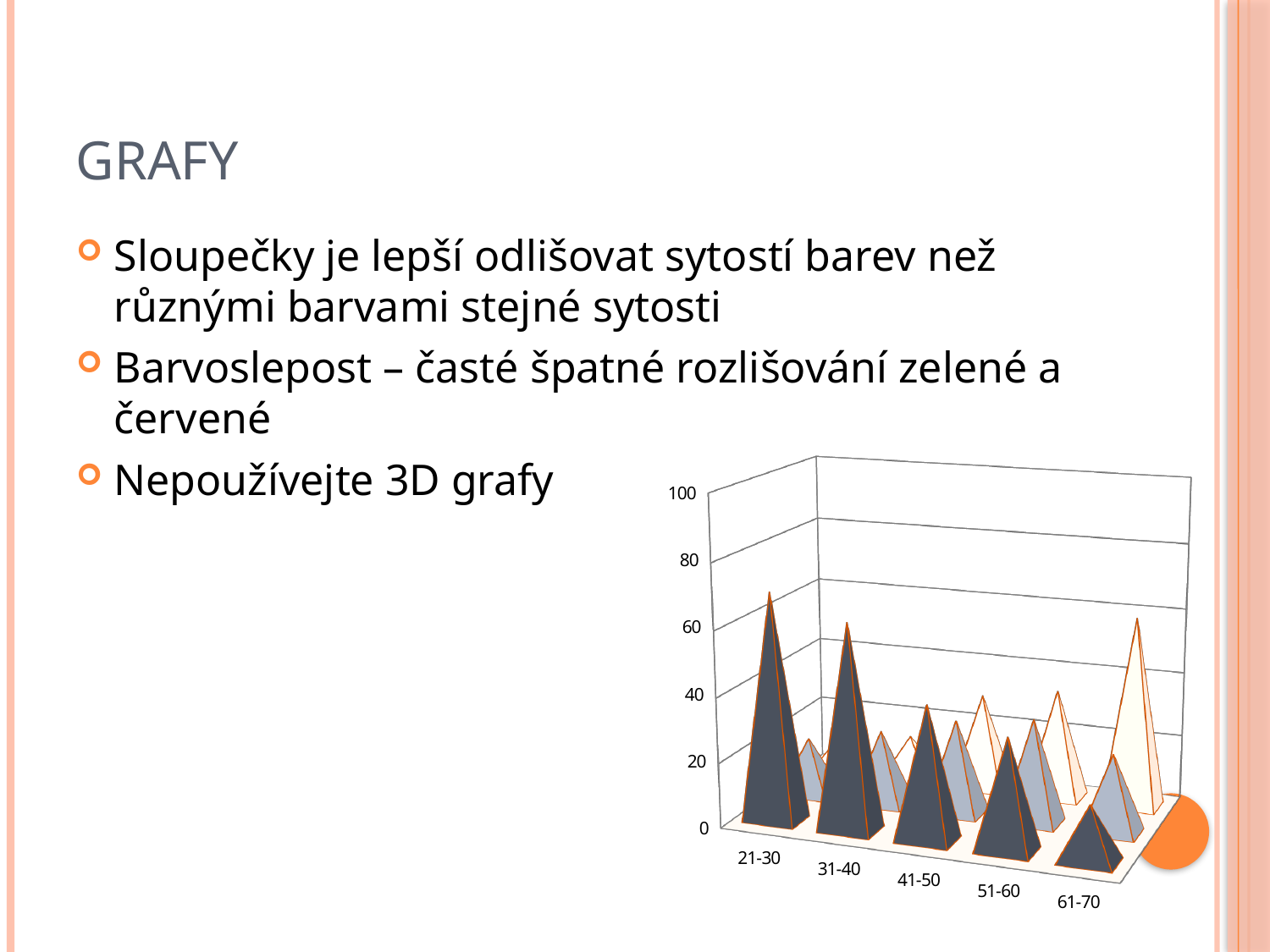
For the dark front series, is the value for 21-30 greater or less than 40? greater How many categories are shown on the x axis of the chart? 5 For the dark front series, is the value for 61-70 greater or less than 40? less What is the first category on the x axis of the chart? 21-30 For the light back series, is the value for 61-70 greater or less than 20? greater For the dark front series, which category has the lowest value? 61-70 For the dark front series, is the value for 21-30 larger or smaller than the value for 61-70? larger For the dark front series, which category has the highest value? 21-30 Do the values of the dark front series rise or fall from 21-30 to 61-70? fall What kind of chart is shown on the slide? bar chart What is the highest value labelled on the vertical axis of the chart? 100